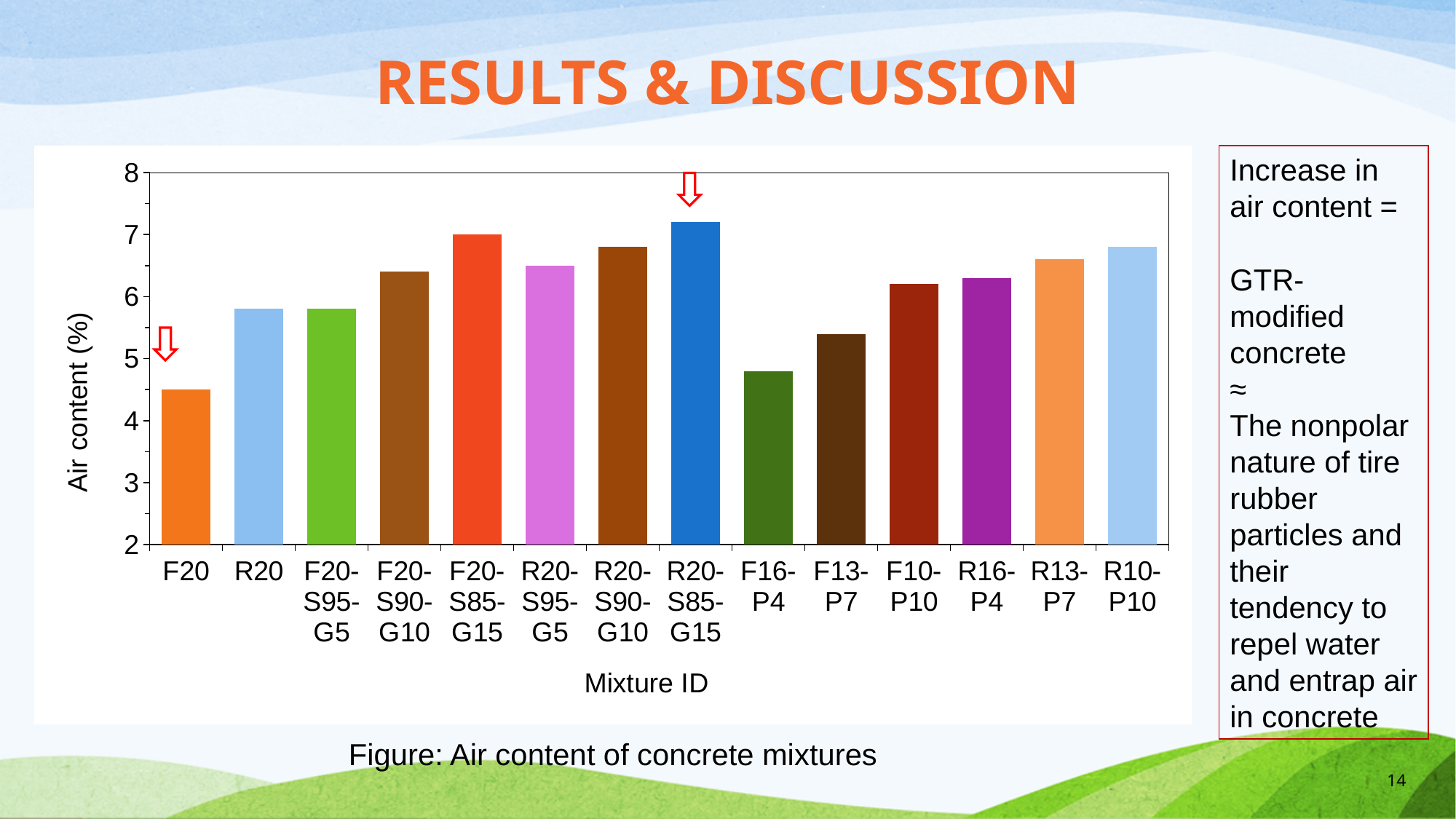
Which mixture has the lowest air content in the chart? F20 Which mixture has the highest air content in the chart? R20-S85-G15 Is the air content for F20 greater or less than 5%? less How many mixtures are plotted on the x axis of the chart? 14 Is the air content for F13-P7 greater or less than 6%? less Which has a higher air content, F16-P4 or R16-P4? R16-P4 Which has a higher air content, F20 or R20? R20 Is the air content for F16-P4 greater or less than 5%? less What is the label of the y axis of the chart? Air content (%) What kind of chart is shown on the slide? bar chart What is the label of the x axis of the chart? Mixture ID